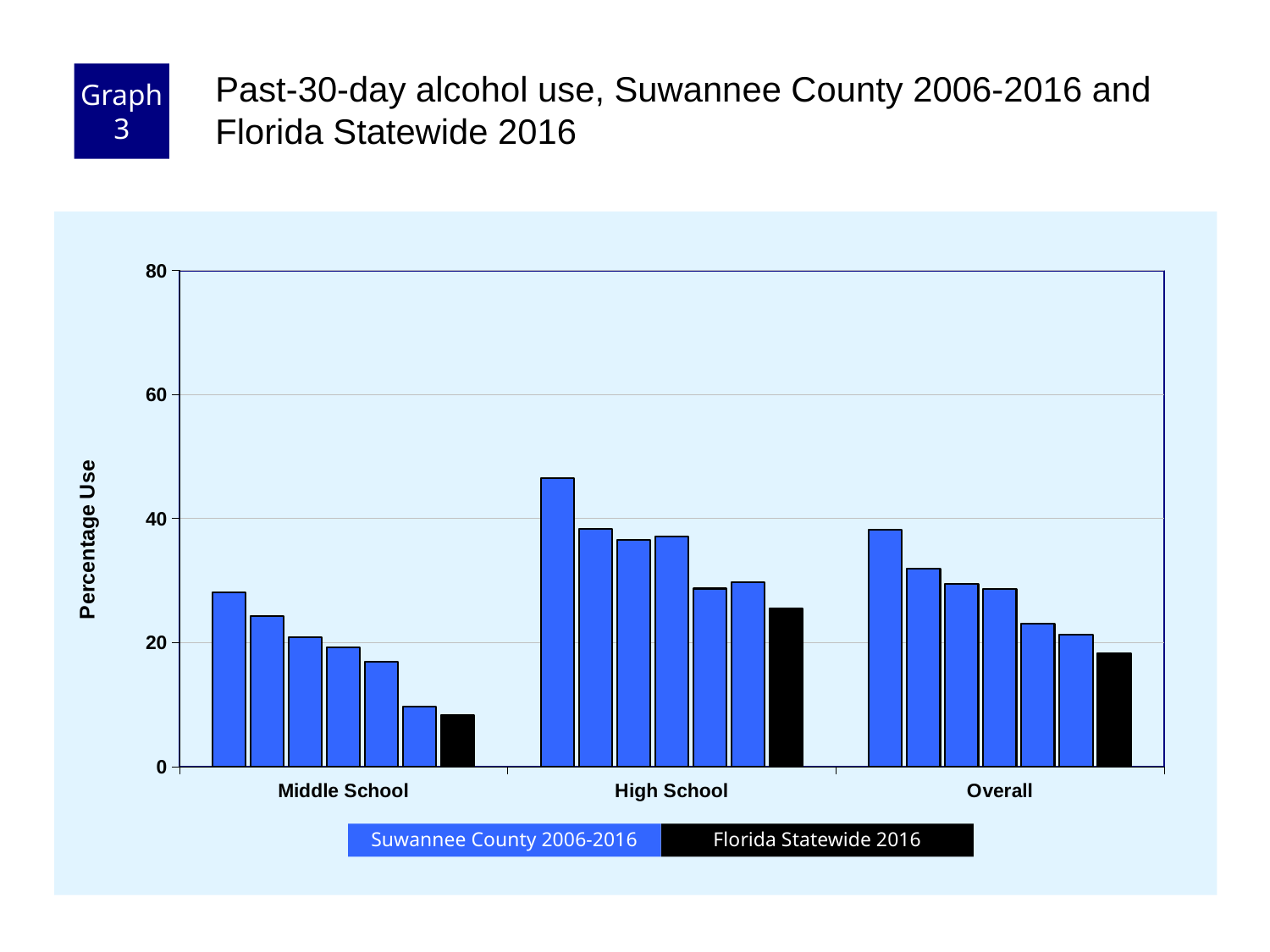
How many series does the legend list? 2 Which is larger, the Florida Statewide 2016 value for High School or for Overall? High School Do the Suwannee County 2006-2016 bars in the Middle School group generally rise or fall from left to right? fall What kind of chart is shown on the slide? bar chart Is the tallest Suwannee County bar in the High School group greater or less than 40? greater Is the Florida Statewide 2016 value for High School greater or less than 20? greater What colour are the Florida Statewide 2016 bars? black Is the Florida Statewide 2016 value for Middle School greater or less than 20? less What is the label on the y axis? Percentage Use Which category has the lowest Florida Statewide 2016 value? Middle School How many categories are shown on the x axis? 3 Which category has the highest Florida Statewide 2016 value? High School